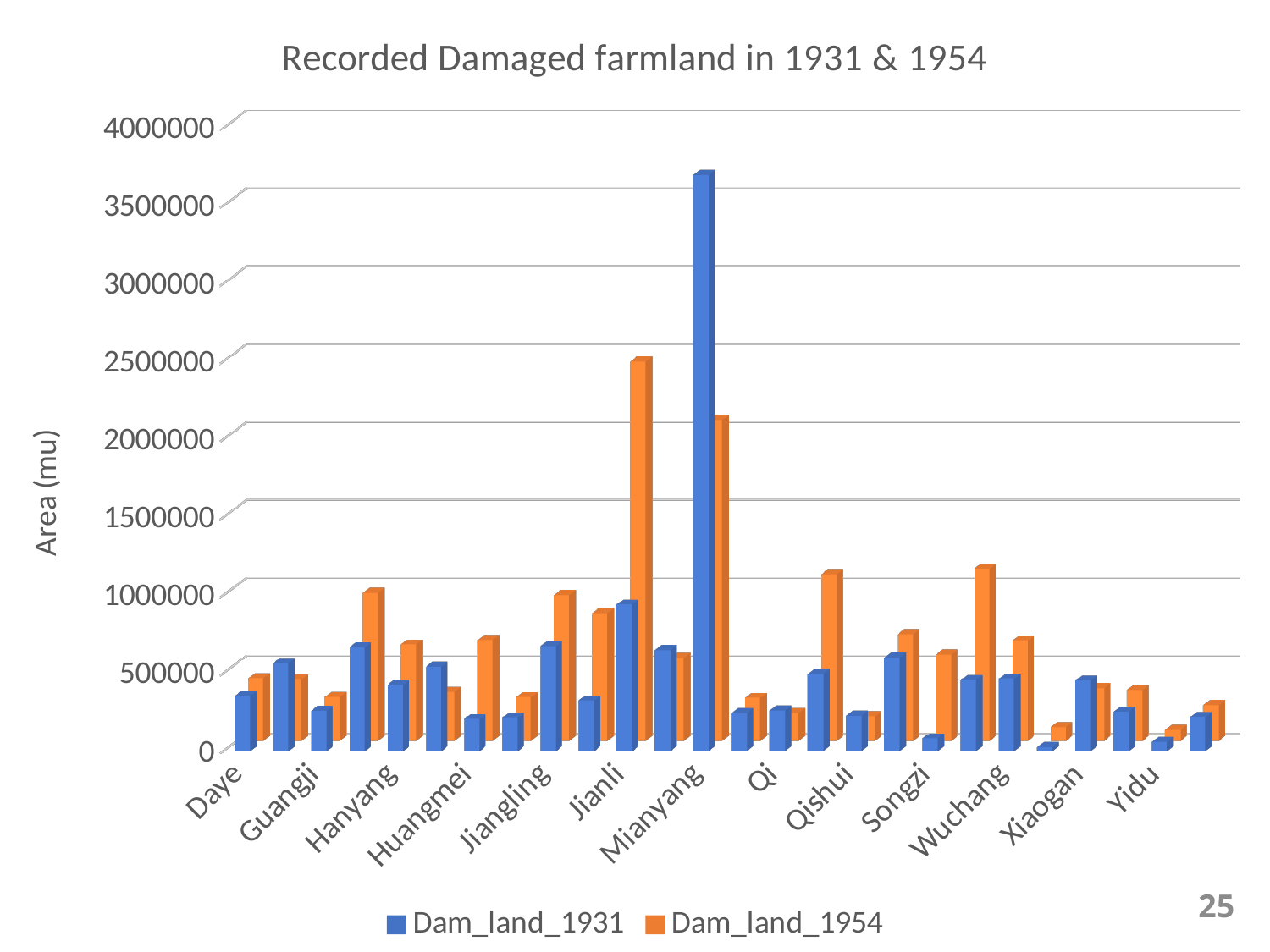
Is the Dam_land_1954 value for Jianli greater or less than 2000000? greater Is the Dam_land_1931 value for Mianyang greater or less than 3500000? greater For Huangmei, which series has the larger value, Dam_land_1931 or Dam_land_1954? Dam_land_1954 For Mianyang, which series has the larger value, Dam_land_1931 or Dam_land_1954? Dam_land_1931 Is the Dam_land_1931 value for Huangmei greater or less than 500000? less What kind of chart is shown on the slide? bar chart What is the label of the vertical axis? Area (mu) Which county has the highest Dam_land_1954 value? Jianli How many series does the legend list? 2 For Jianli, which series has the larger value, Dam_land_1931 or Dam_land_1954? Dam_land_1954 Which county has the highest Dam_land_1931 value? Mianyang